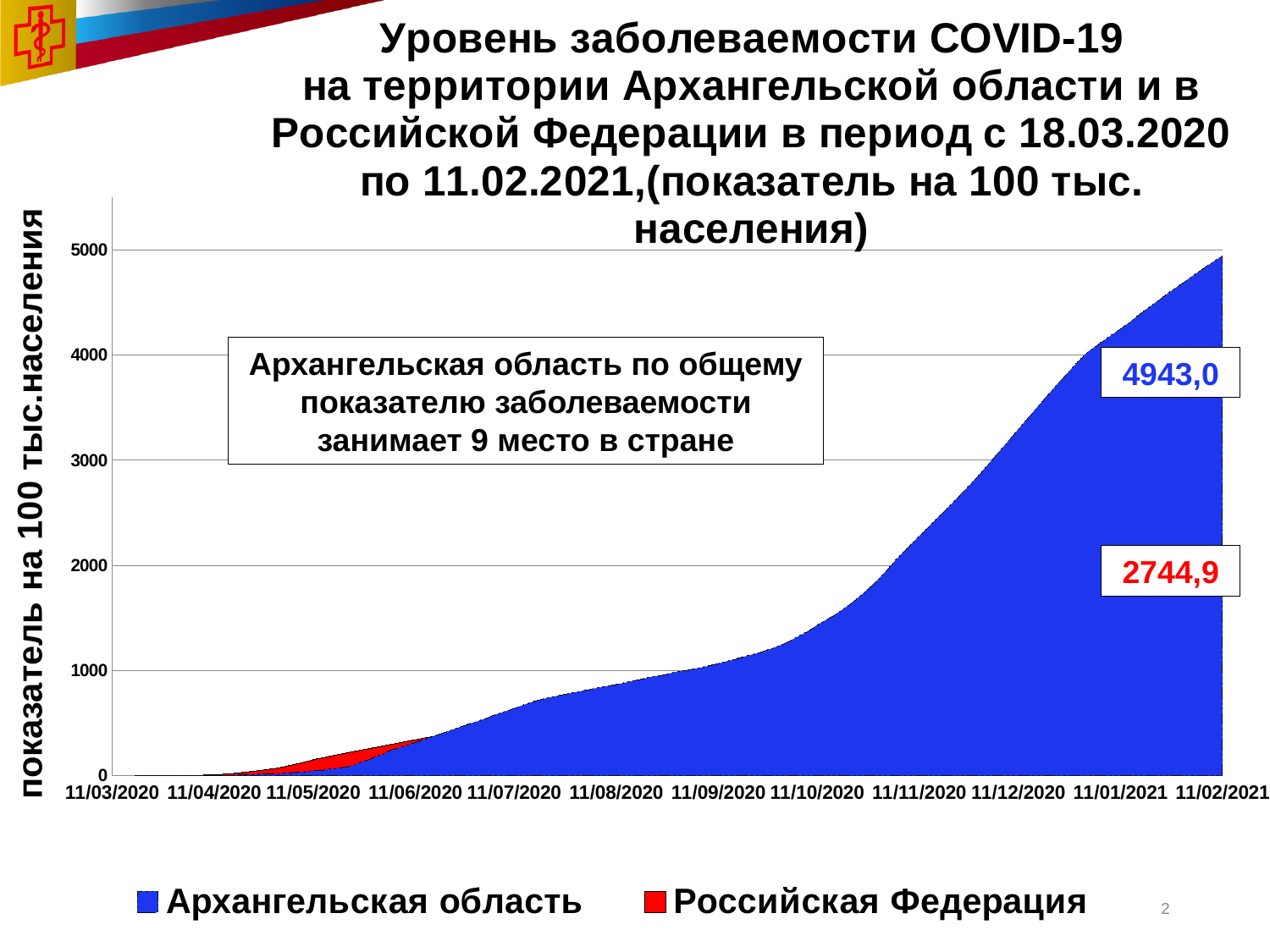
What kind of chart is shown on the slide? Area chart Is the value for Архангельская область at 11/07/2020 greater or less than 1000? less Is the value for Архангельская область at 11/10/2020 greater or less than 1000? greater What is the final value shown for Архангельская область? 4943,0 What is the difference between the labelled final values for Архангельская область (4943,0) and Российская Федерация (2744,9)? 2198,1 How many series does the legend list? 2 Which colour represents Российская Федерация in the chart? Red How many date labels are shown on the x axis? 12 Which series has the larger labelled final value, Архангельская область or Российская Федерация? Архангельская область What is the label of the vertical axis? показатель на 100 тыс.населения Does the value for Архангельская область rise or fall over time along the x axis? Rises What is the final value shown for Российская Федерация? 2744,9